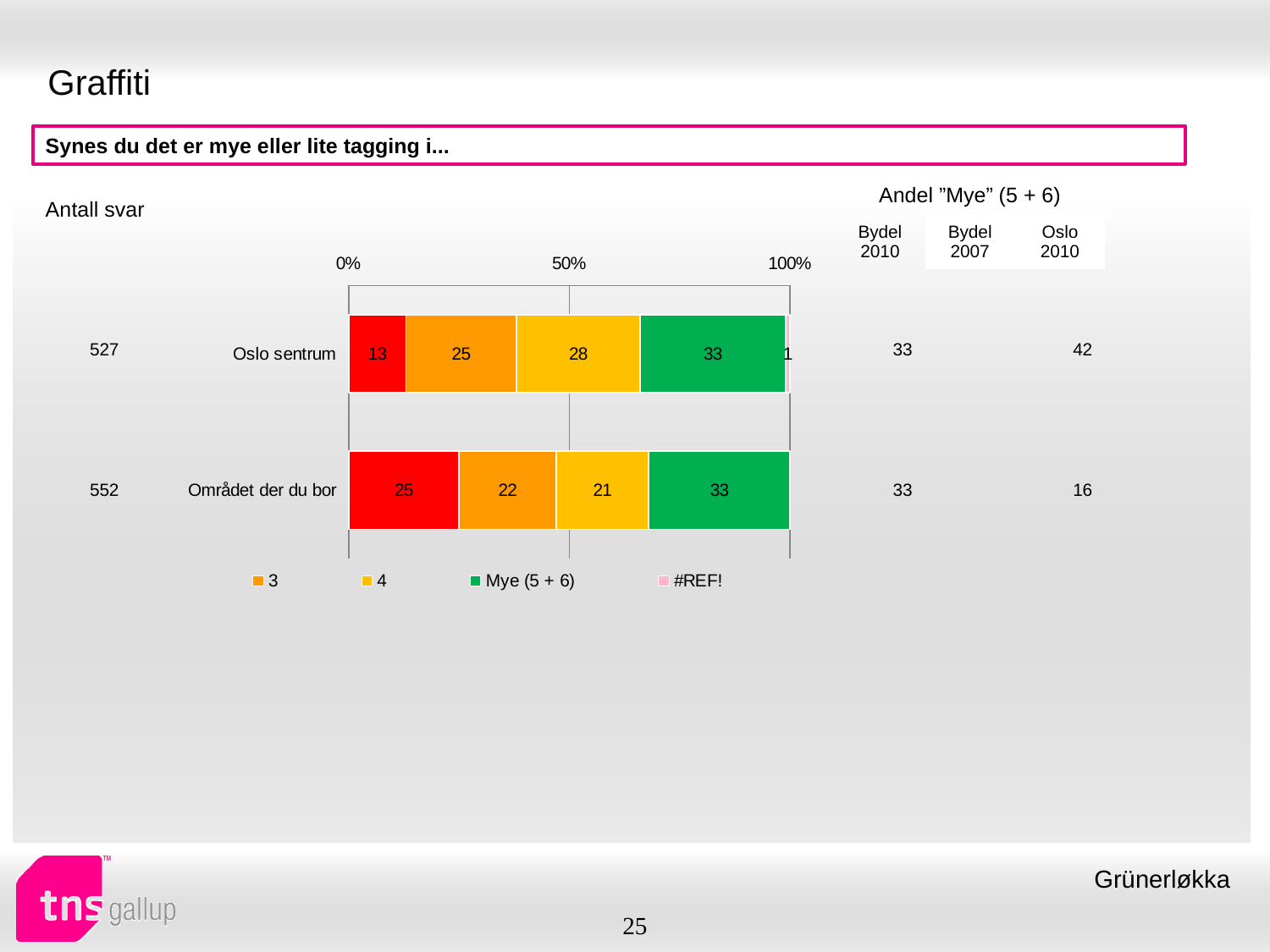
What value is printed on the red segment for Området der du bor? 25 Which category has the larger '4' segment, Oslo sentrum or Området der du bor? Oslo sentrum What is the value of the '3' segment for Oslo sentrum? 25 What is the value of the Mye (5 + 6) segment for Oslo sentrum? 33 What is the difference between the '4' segment values for Oslo sentrum and Området der du bor? 7 What is the value of the '4' segment for Området der du bor? 21 How many entries does the chart legend list? 4 What is the value of the Mye (5 + 6) segment for Området der du bor? 33 What is the value of the '3' segment for Området der du bor? 22 What kind of chart is shown on the slide? bar chart How many categories are plotted in the chart? 2 What question text is shown in the box above the chart? Synes du det er mye eller lite tagging i...